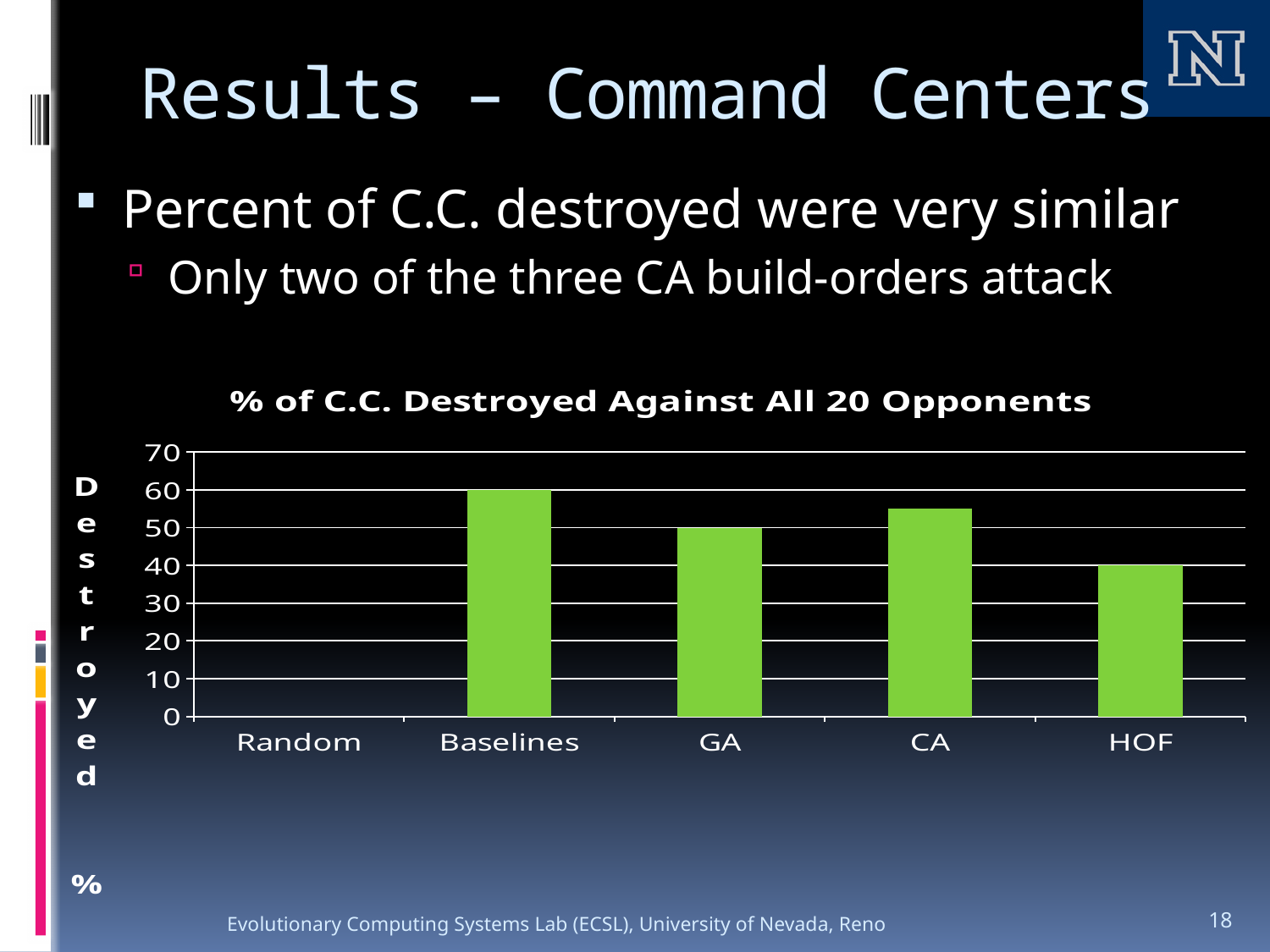
Which category has the lowest value? Random What is the value for HOF? 40 Is the value for CA greater or less than 50? greater What is the difference between the values for Baselines and HOF? 20 What is the value for Random? 0 What is the value for Baselines? 60 How many categories are shown on the x axis of the chart? 5 Which is larger, the value for GA or the value for HOF? GA What is the value for GA? 50 Which category has the highest value? Baselines What type of chart is shown on the slide? bar chart What is the title of the chart? % of C.C. Destroyed Against All 20 Opponents